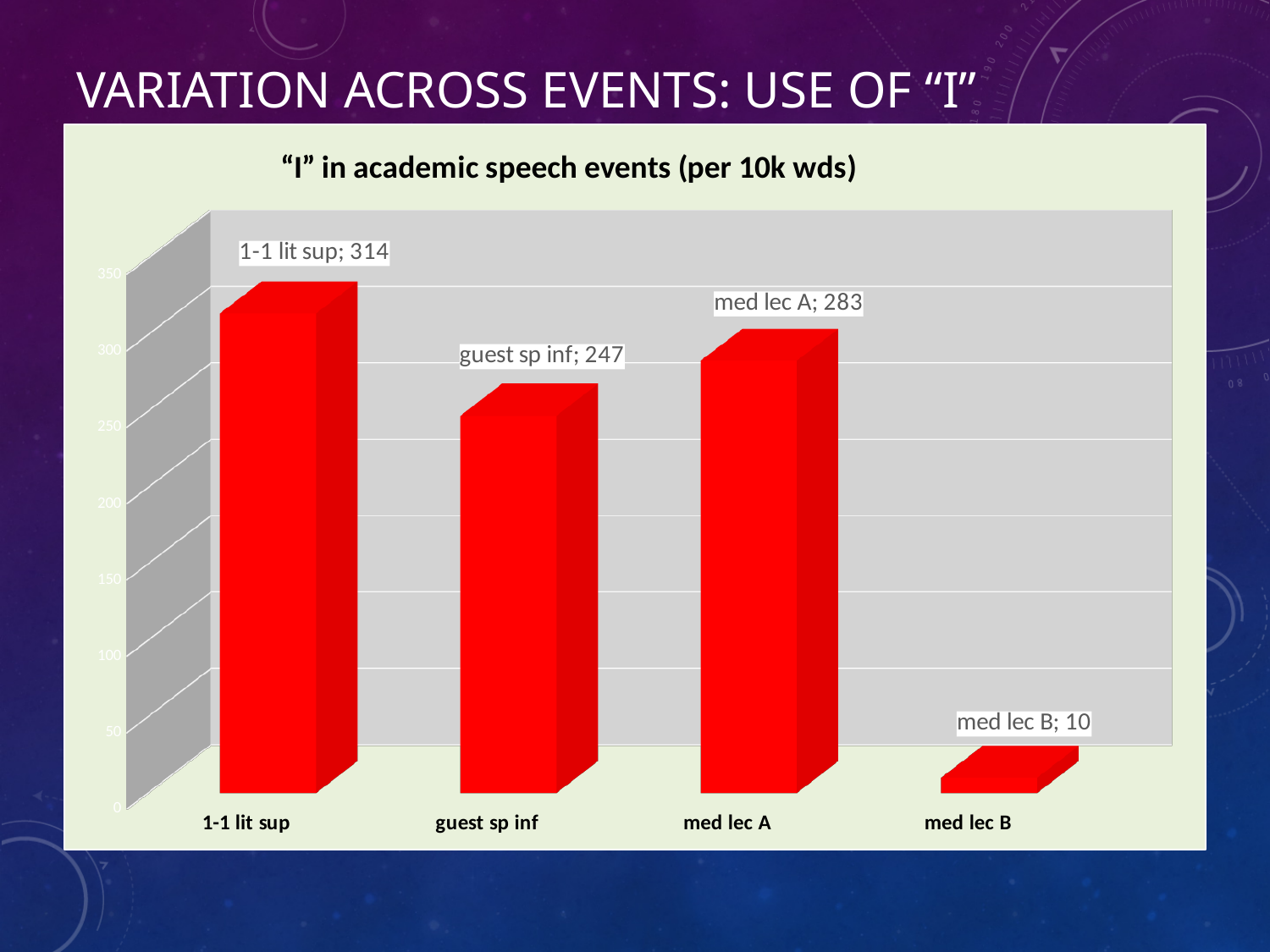
What is the difference between the values for med lec A and guest sp inf? 36 Which is larger, the value for guest sp inf or the value for med lec A? med lec A What is the title of the chart? "I" in academic speech events (per 10k wds) How many categories are shown on the x axis? 4 What is the value for 1-1 lit sup? 314 What is the value for guest sp inf? 247 What is the value for med lec B? 10 Which category has the highest value? 1-1 lit sup What is the value for med lec A? 283 What is the difference between the values for 1-1 lit sup and med lec A? 31 Which category has the lowest value? med lec B What kind of chart is shown on the slide? bar chart